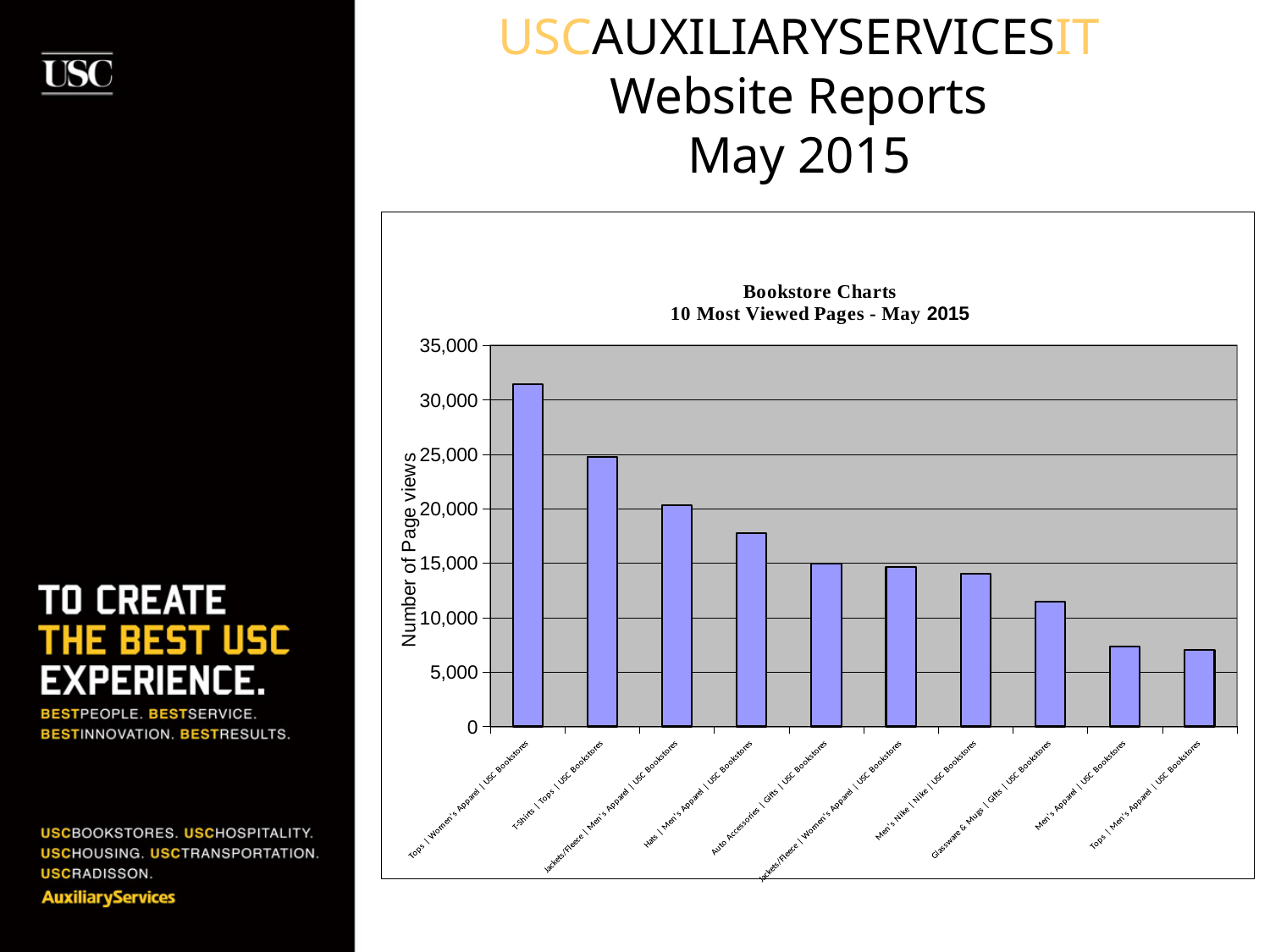
Do the page view values rise or fall from left to right across the chart? Fall How many pages (bars) are shown in the chart? 10 Is the value for Tops | Women's Apparel | USC Bookstores greater or less than 30,000? greater Which page has the highest number of page views? Tops | Women's Apparel | USC Bookstores Is the value for Hats | Men's Apparel | USC Bookstores greater or less than 15,000? greater What is the label of the vertical axis? Number of Page views Is the value for Glassware & Mugs | Gifts | USC Bookstores greater or less than 10,000? greater Which has more page views: Jackets/Fleece | Men's Apparel | USC Bookstores or Men's Nike | Nike | USC Bookstores? Jackets/Fleece | Men's Apparel | USC Bookstores Which page has the lowest number of page views? Tops | Men's Apparel | USC Bookstores What kind of chart is shown on the slide? Bar chart